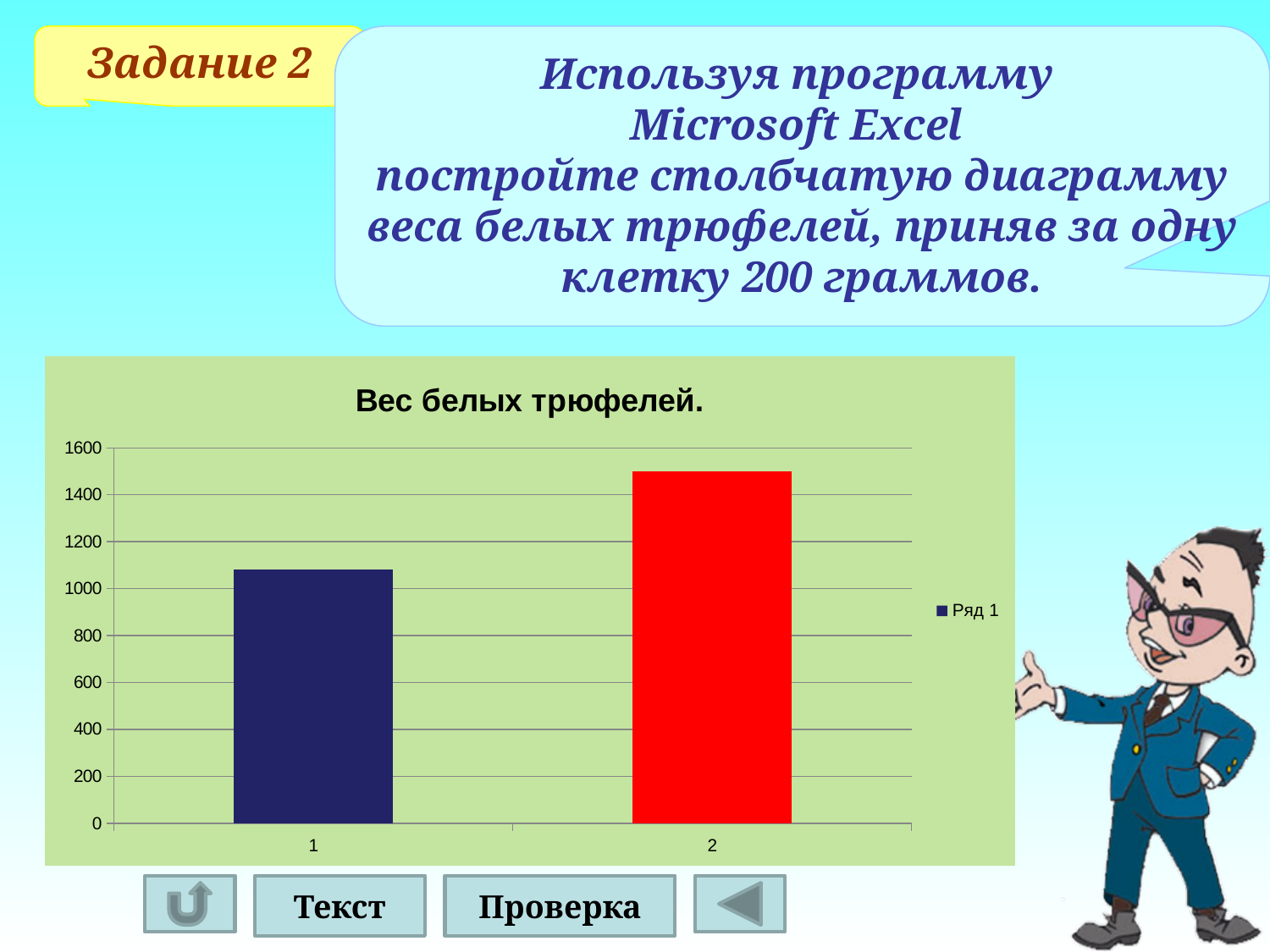
Is the value for category 1 greater or less than 1200? less Which category has the lowest bar? 1 Which is larger, the value for category 1 or category 2? 2 Is the value for category 2 greater or less than 1400? greater Is the value for category 1 greater or less than 1000? greater Which category has the highest bar? 2 What kind of chart is shown on the slide? bar chart What is the title of the chart? Вес белых трюфелей. How many bars are plotted in the chart? 2 How many series does the legend list? 1 What is the name of the series shown in the legend? Ряд 1